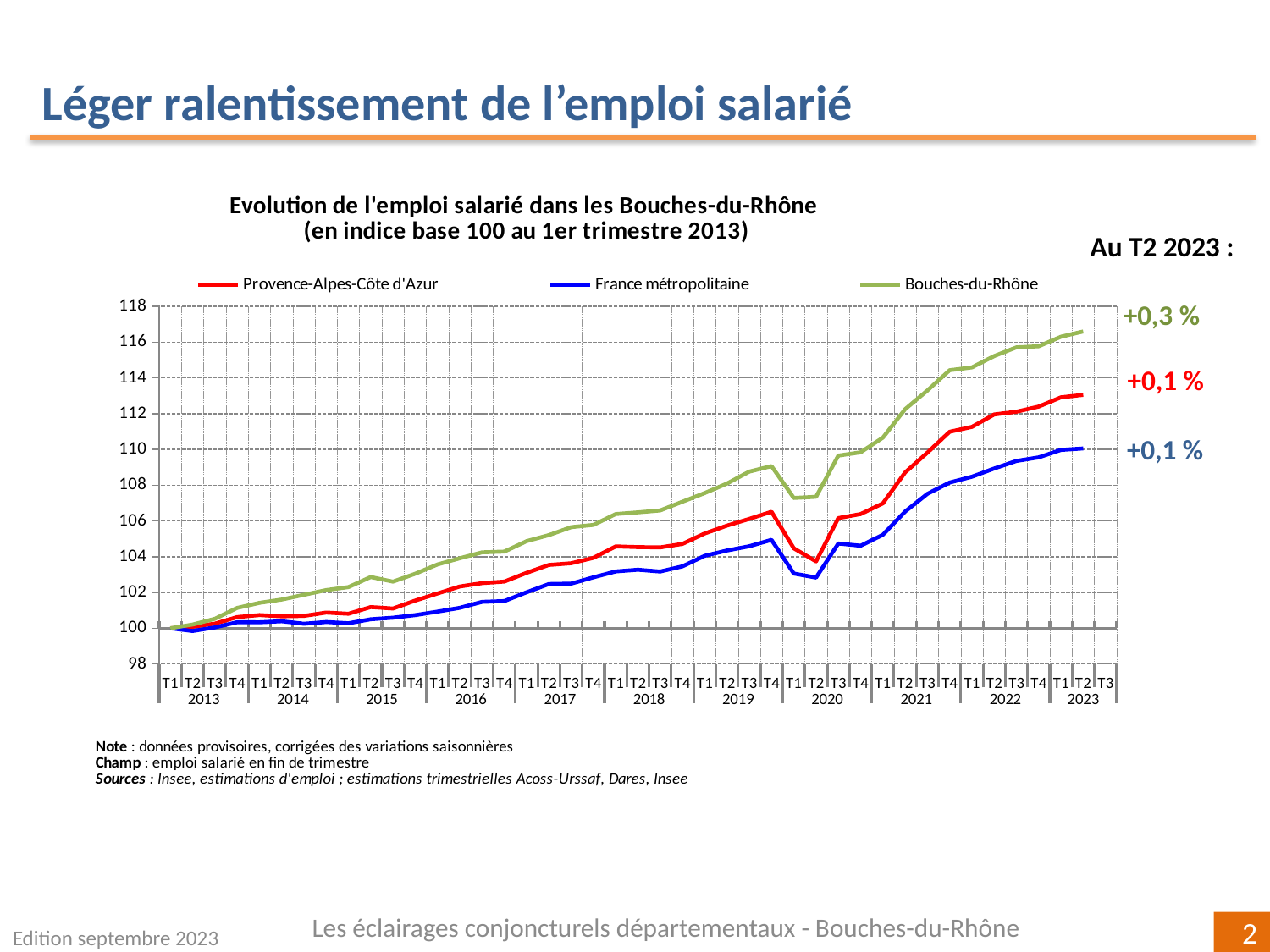
How many series does the chart legend list? 3 What is the index value of all three series at T1 2013? 100 What quarterly change is annotated for Bouches-du-Rhône at T2 2023? +0,3 % Which series has the lowest value at T2 2023? France métropolitaine Which series has the highest value at T2 2023? Bouches-du-Rhône What kind of chart is shown on the slide? line chart What colour is the line for Bouches-du-Rhône? green Is the value for Bouches-du-Rhône at T2 2023 greater or less than 114? greater What is the title of the chart? Evolution de l'emploi salarié dans les Bouches-du-Rhône (en indice base 100 au 1er trimestre 2013) Is the value for France métropolitaine at T2 2023 greater or less than 112? less At T2 2020, which is higher: Bouches-du-Rhône or France métropolitaine? Bouches-du-Rhône Is the value for Provence-Alpes-Côte d'Azur at T2 2023 greater or less than 110? greater